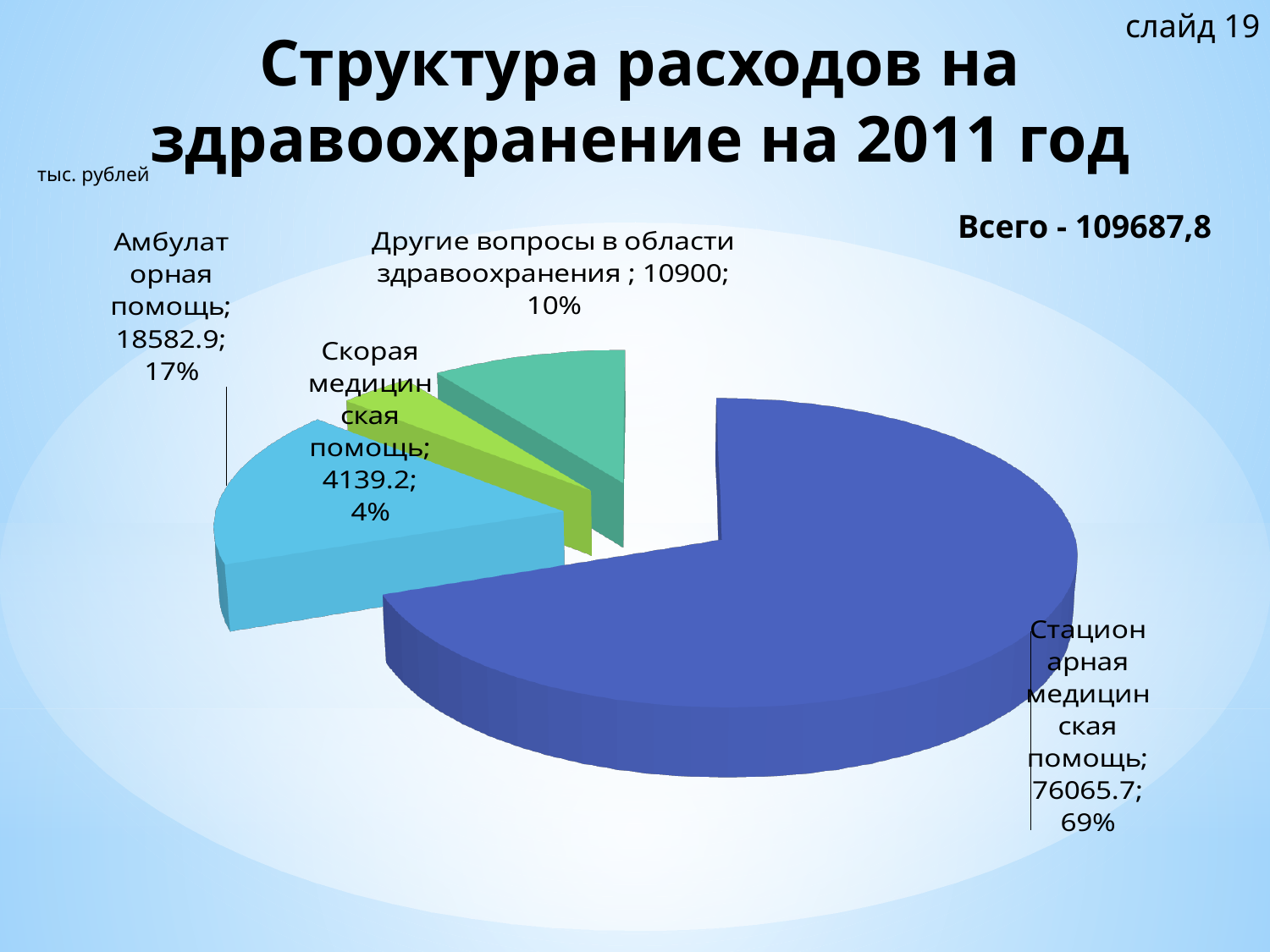
Which is larger: the value for Амбулаторная помощь or the value for Другие вопросы в области здравоохранения? Амбулаторная помощь What kind of chart is shown on the slide? Pie chart What is the value for Скорая медицинская помощь? 4139.2 What is the value for Другие вопросы в области здравоохранения? 10900 What share of the pie does Амбулаторная помощь represent? 17% What is the value for Стационарная медицинская помощь? 76065.7 What share of the pie does Другие вопросы в области здравоохранения represent? 10% Which category has the smallest share of the pie? Скорая медицинская помощь What is the value for Амбулаторная помощь? 18582.9 Which category has the largest share of the pie? Стационарная медицинская помощь How many slices does the pie chart have? 4 What is the difference between the values for Амбулаторная помощь and Скорая медицинская помощь? 14443.7